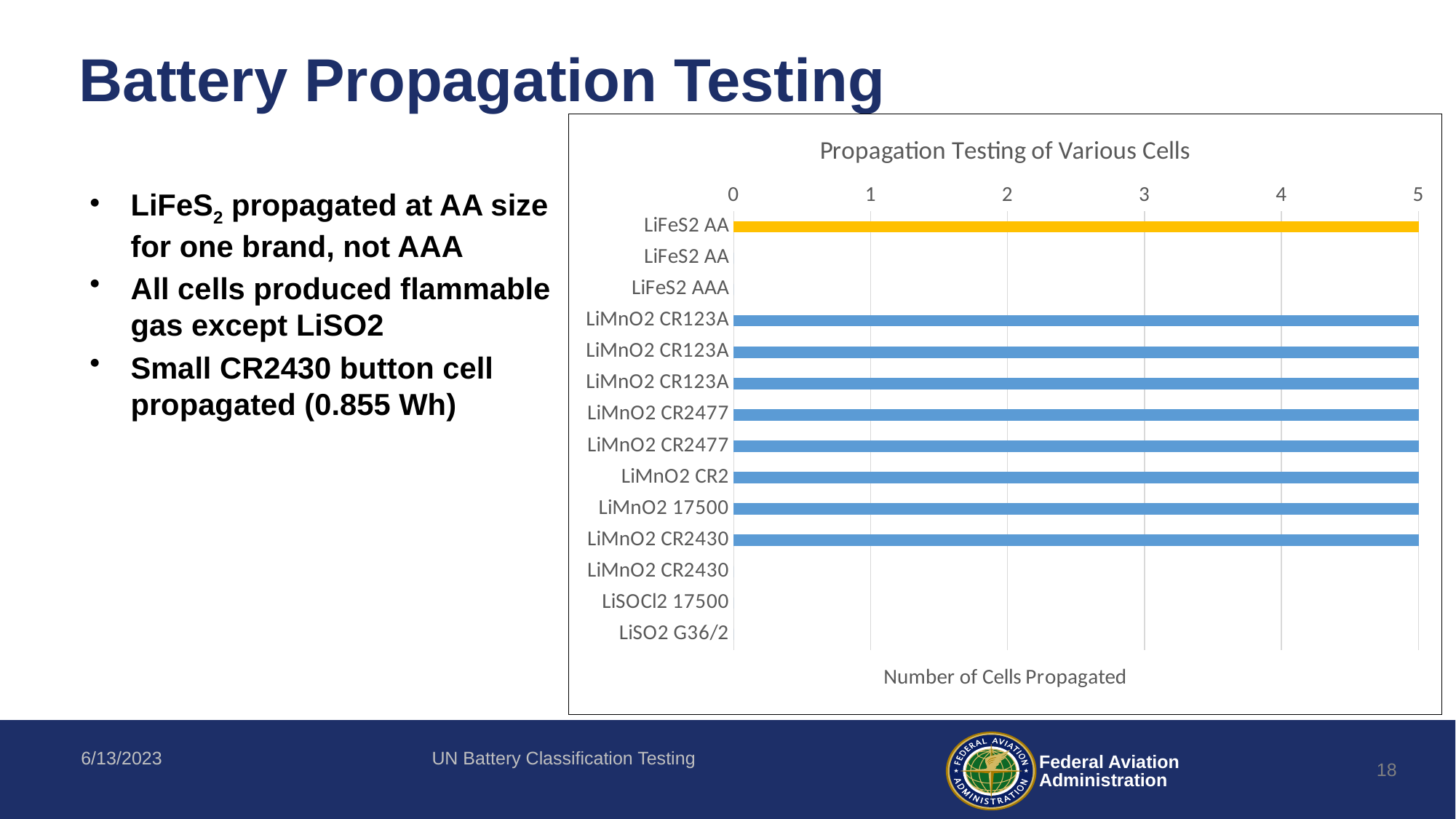
What is the value for LiMnO2 CR2 in the chart? 5 What is the value for LiFeS2 AAA in the chart? 0 What is the title of the chart? Propagation Testing of Various Cells What is the value for LiSO2 G36/2 in the chart? 0 How many categories are listed on the vertical axis of the chart? 14 Which is larger in the chart, the value for LiMnO2 CR2 or the value for LiSOCl2 17500? LiMnO2 CR2 What is the value for LiSOCl2 17500 in the chart? 0 What is the value for LiMnO2 17500 in the chart? 5 What is the value of the yellow bar (the top LiFeS2 AA entry) in the chart? 5 What is the difference between the value for LiMnO2 17500 and the value for LiFeS2 AAA in the chart? 5 What is the label of the horizontal axis of the chart? Number of Cells Propagated What kind of chart is shown on the slide? bar chart